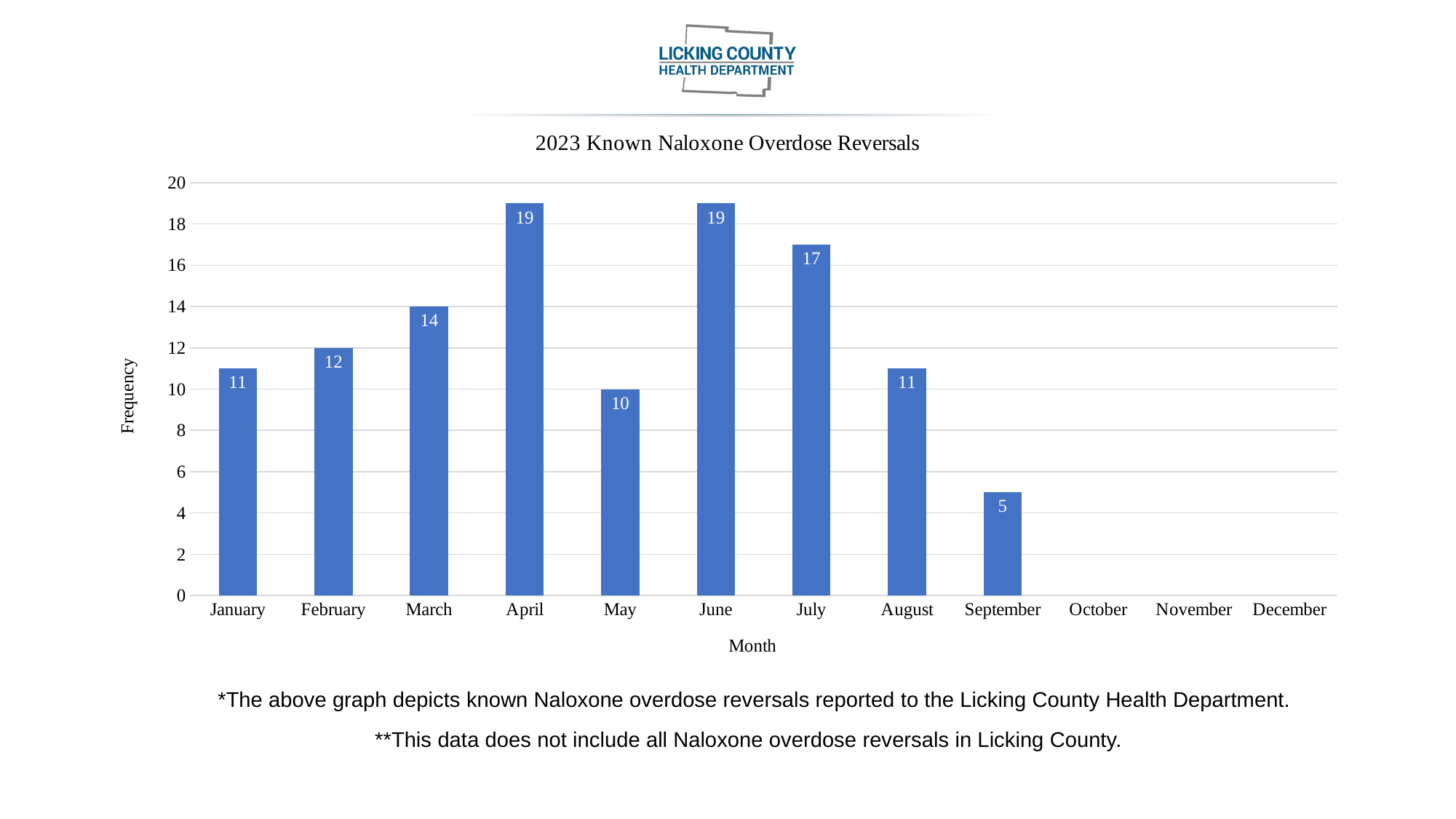
Which months share the highest value? April and June How many months have a bar plotted on the chart? 9 What is the value for July? 17 What is the value for March? 14 What is the value for April? 19 What is the difference between the values for June and May? 9 What is the value for September? 5 Is the value for July greater or less than 16? greater Which month has the lowest value among the months with a bar? September Which is larger, the value for February or the value for August? February What kind of chart is shown on the slide? Bar chart What is the title of the chart? 2023 Known Naloxone Overdose Reversals